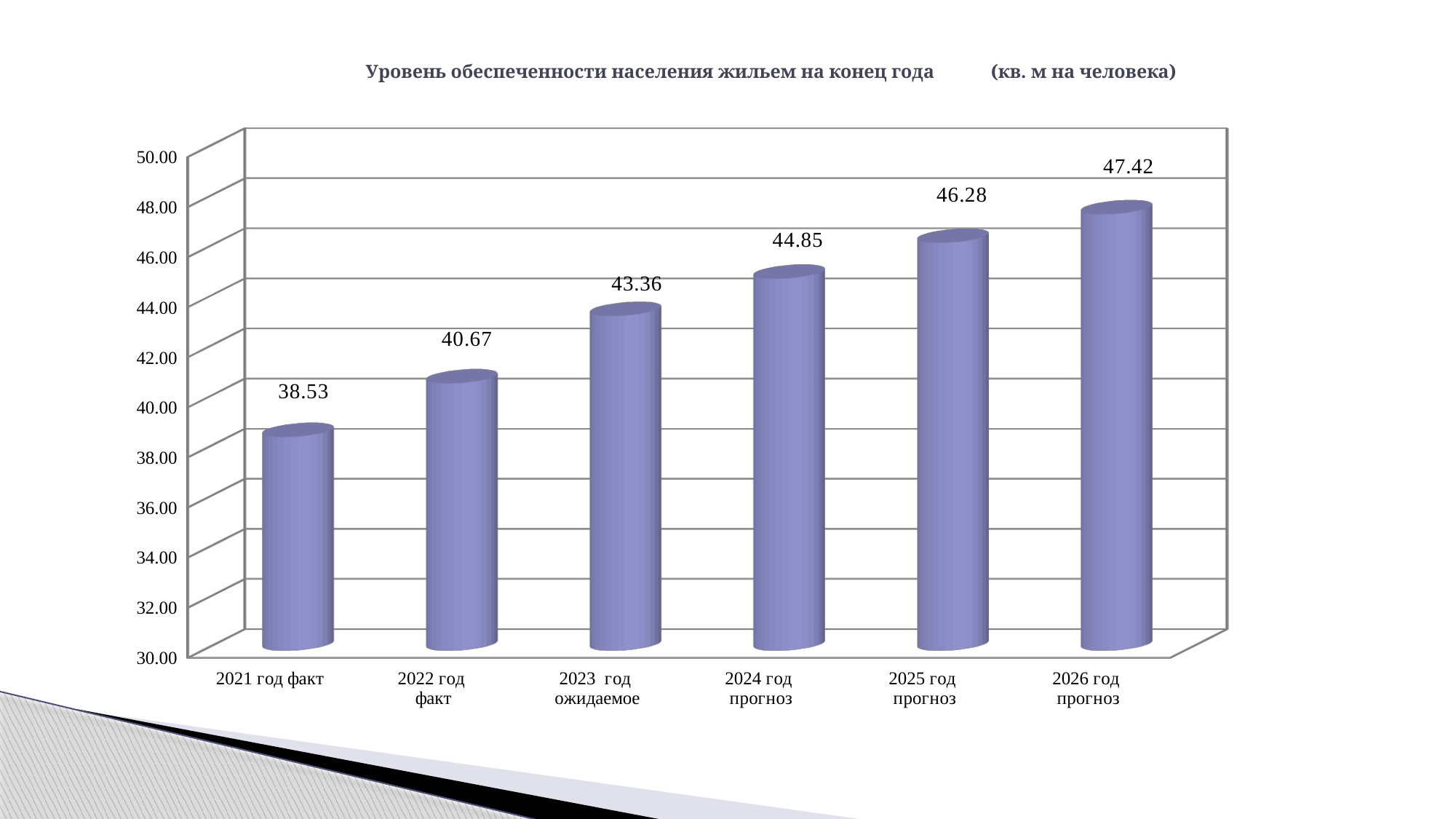
What is the difference between the values for 2023 год ожидаемое and 2022 год факт? 2.69 Is the value for 2022 год факт greater or less than 42.00? less What kind of chart is this? bar chart What is the value for 2024 год прогноз? 44.85 Which category has the highest value? 2026 год прогноз What is the difference between the values for 2026 год прогноз and 2021 год факт? 8.89 Which category has the lowest value? 2021 год факт What is the value for 2021 год факт? 38.53 Do the values rise or fall from 2021 to 2026? rise Which is larger, the value for 2025 год прогноз or the value for 2024 год прогноз? 2025 год прогноз What is the value for 2026 год прогноз? 47.42 How many categories are shown on the chart? 6